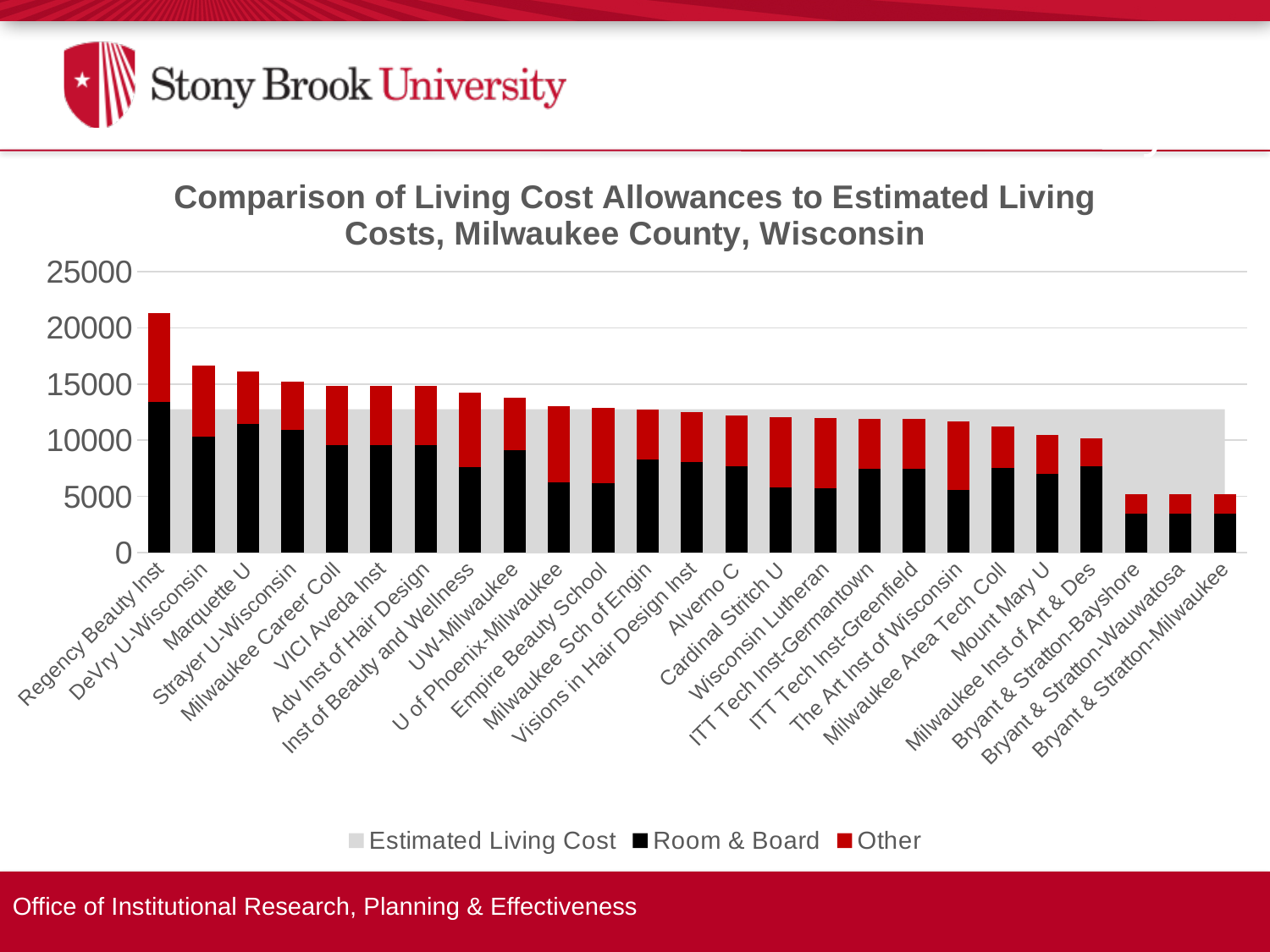
Is the Room & Board value for Bryant & Stratton-Wauwatosa greater or less than 5000? less What kind of chart is shown on the slide? Stacked bar chart Do the total living cost allowances generally rise or fall moving from left to right along the x axis? Fall Is the total living cost allowance for DeVry U-Wisconsin greater or less than 15000? greater Which has the larger total living cost allowance, Regency Beauty Inst or DeVry U-Wisconsin? Regency Beauty Inst Is the Room & Board value for Regency Beauty Inst greater or less than 10000? greater Which institution has the highest total living cost allowance (Room & Board plus Other)? Regency Beauty Inst How many institutions are shown along the x axis? 25 How many series does the legend list? 3 Which series is shown in black in the legend? Room & Board